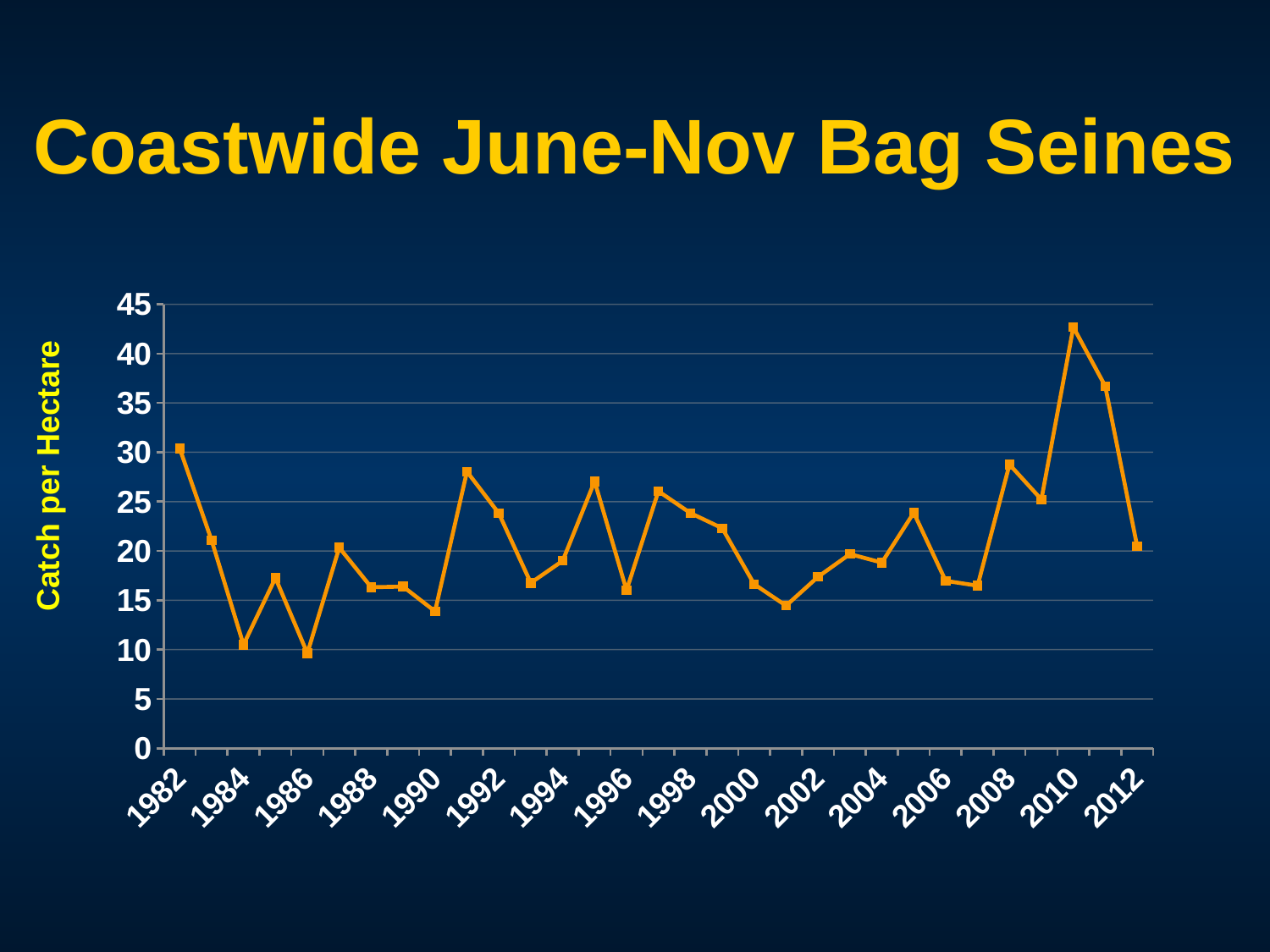
Is the value for 2012 greater or less than 25? less Is the value for 1986 greater or less than 15? less Do the values rise or fall from 2010 to 2012? fall Which year has the highest catch per hectare? 2010 What is the label on the vertical axis? Catch per Hectare What kind of chart is shown on the slide? line chart How many yearly data points are plotted on the chart? 31 Is the value for 1991 greater or less than 25? greater Which year has the larger catch per hectare, 1991 or 1996? 1991 Which year has the larger catch per hectare, 2010 or 1982? 2010